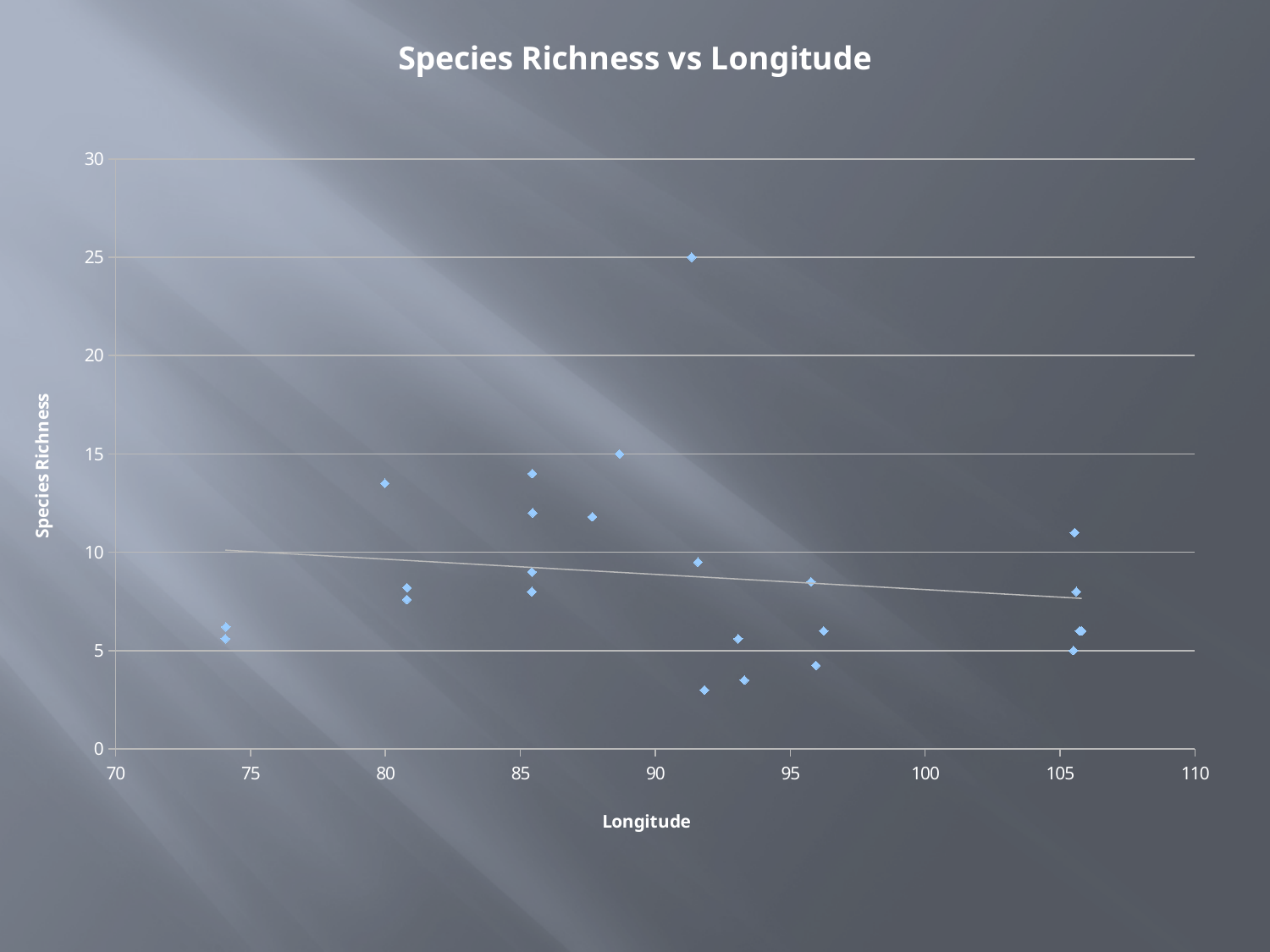
Does the trendline in the chart rise or fall as longitude increases? fall Is the highest species richness point located at a longitude greater or less than 90? greater What kind of chart is shown on the slide? scatter chart What is the title of the chart? Species Richness vs Longitude At longitude 105, is the trendline above or below a species richness of 10? below Which has the higher species richness: the point near longitude 80 or the points near longitude 74? the point near longitude 80 Are the species richness values of the points near longitude 74 greater or less than 10? less What are the x-axis and y-axis titles of the chart? Longitude and Species Richness